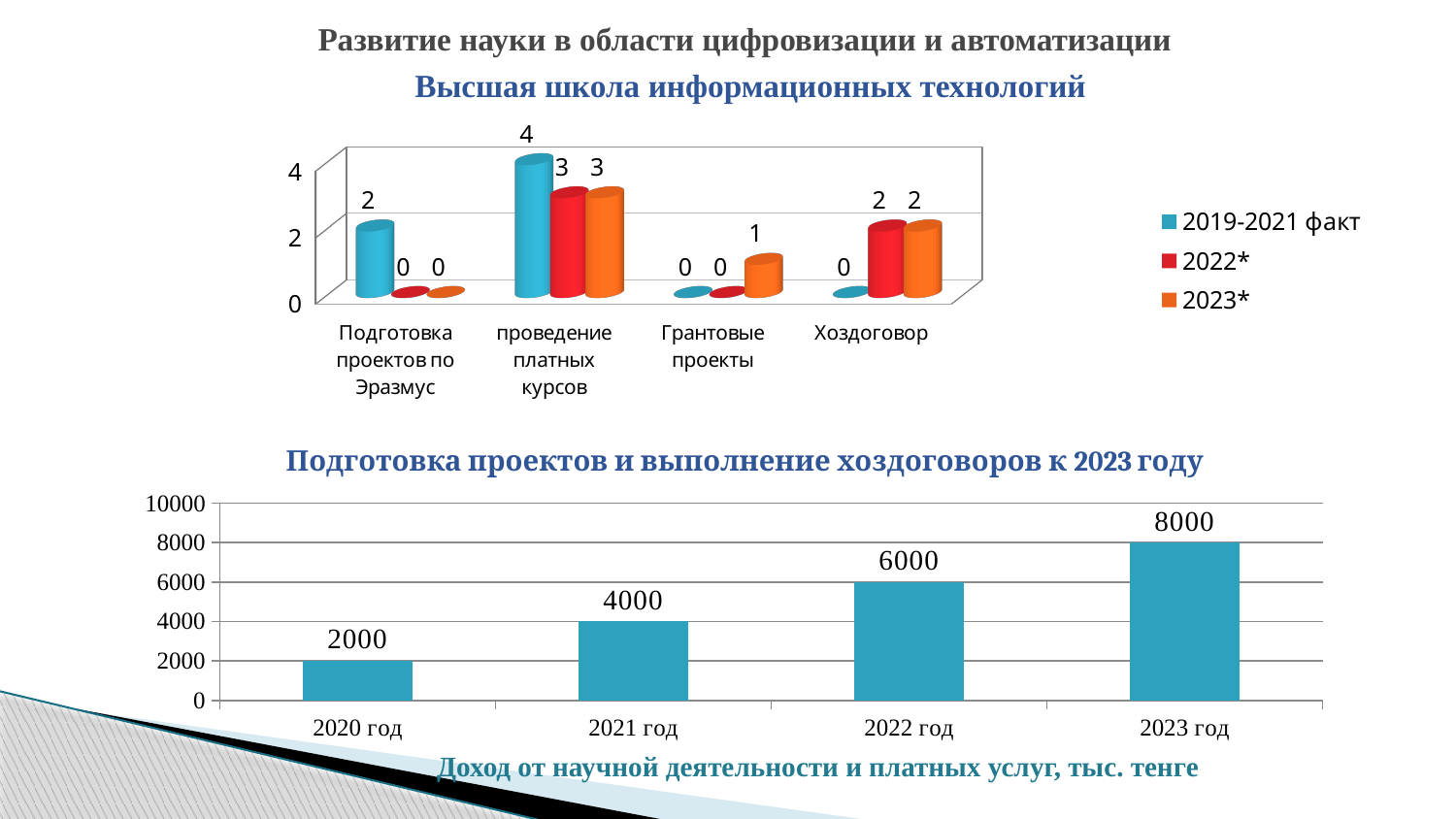
What kind of chart is the bottom chart (Подготовка проектов и выполнение хоздоговоров к 2023 году)? bar chart In the top chart (Высшая школа информационных технологий), how many series does the legend list? 3 In the top chart (Высшая школа информационных технологий), what is the value for проведение платных курсов in the 2019-2021 факт series? 4 In the top chart (Высшая школа информационных технологий), which category has the highest value in the 2019-2021 факт series? проведение платных курсов In the top chart (Высшая школа информационных технологий), how many categories are shown on the x axis? 4 In the bottom chart (Подготовка проектов и выполнение хоздоговоров к 2023 году), what is the value for 2021 год? 4000 In the top chart (Высшая школа информационных технологий), what is the value for Хоздоговор in the 2022* series? 2 In the bottom chart (Подготовка проектов и выполнение хоздоговоров к 2023 году), which year has the lowest value? 2020 год In the bottom chart (Подготовка проектов и выполнение хоздоговоров к 2023 году), do the values rise or fall from 2020 год to 2023 год? rise In the bottom chart (Подготовка проектов и выполнение хоздоговоров к 2023 году), what is the difference between the values for 2023 год and 2020 год? 6000 In the top chart (Высшая школа информационных технологий), what is the value for Грантовые проекты in the 2023* series? 1 In the top chart (Высшая школа информационных технологий), what is the difference between the 2019-2021 факт value and the 2022* value for проведение платных курсов? 1